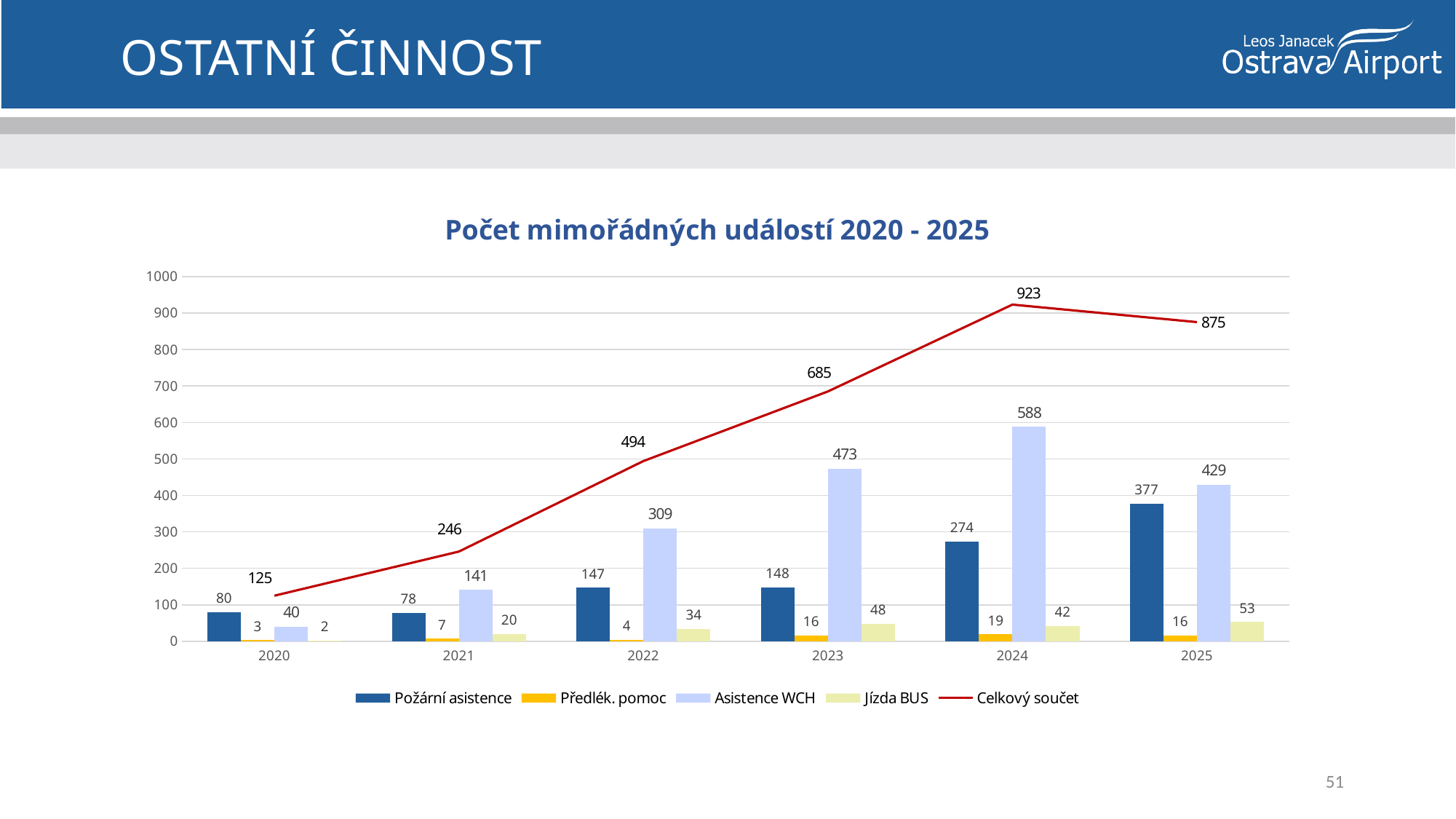
How many series does the legend list? 5 What is the value of Jízda BUS in 2025? 53 What is the value of Předlék. pomoc in 2021? 7 In which year is the Požární asistence value lowest? 2021 What is the difference between the Celkový součet values for 2024 and 2025? 48 How many years are shown on the x axis? 6 Which is larger in 2025: Požární asistence or Asistence WCH? Asistence WCH What is the title of the chart? Počet mimořádných událostí 2020 - 2025 Is the Celkový součet value for 2023 greater or less than 600? greater What is the Celkový součet value for 2022? 494 In which year is the Celkový součet line highest? 2024 What is the value of Asistence WCH in 2024? 588